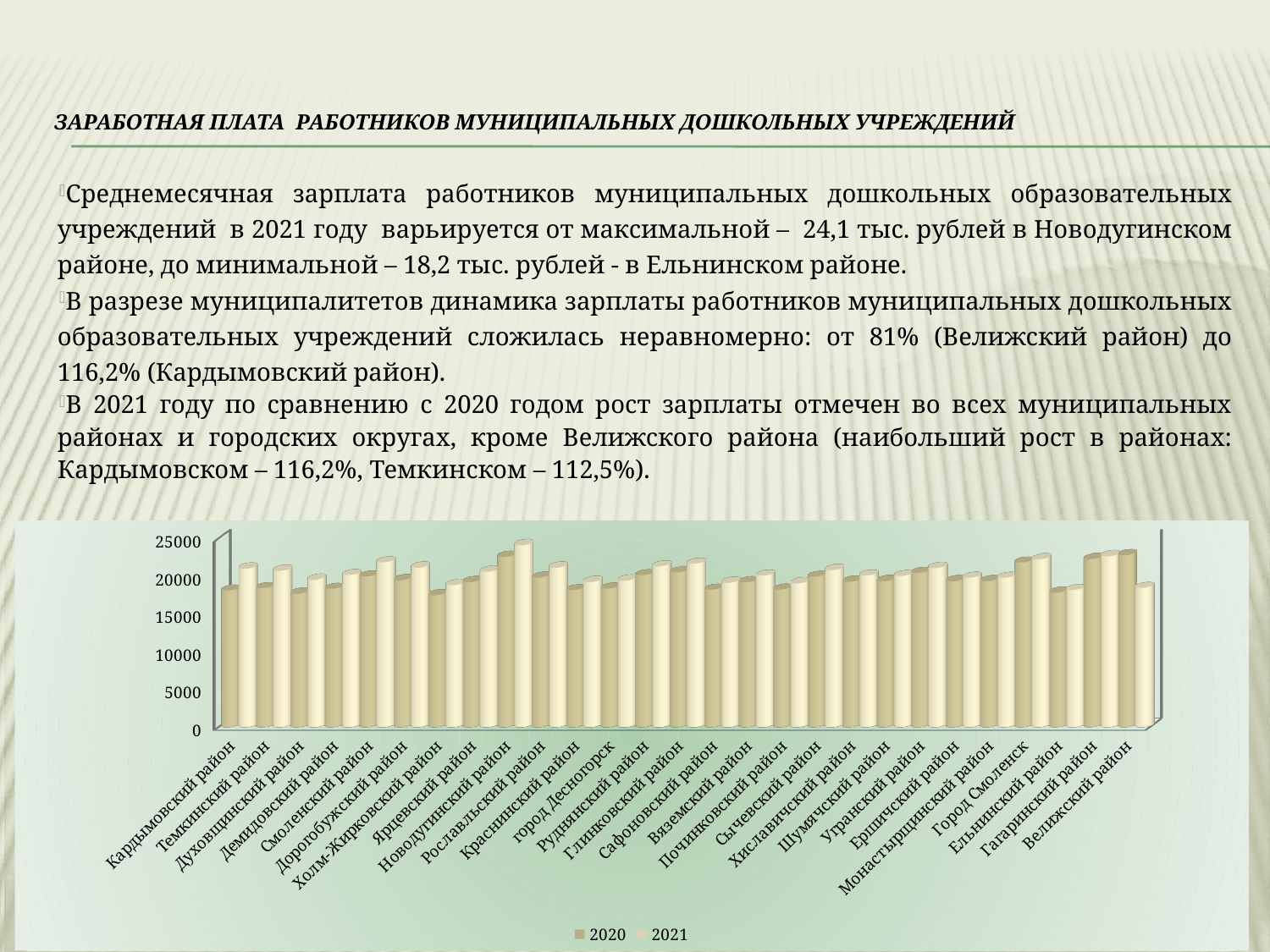
Which is larger: the 2021 value for Новодугинский район or the 2021 value for Кардымовский район? Новодугинский район What kind of chart is shown on the slide? bar chart How many series does the chart legend list? 2 Is the 2021 value for Ельнинский район greater or less than 20000? less Is the 2021 value for Город Смоленск greater or less than 20000? greater Which years are listed in the chart legend? 2020 and 2021 How many municipalities (categories) are shown on the x axis of the chart? 27 Which municipality has the highest 2021 bar in the chart? Новодугинский район Is the 2020 value for Кардымовский район greater or less than 20000? less What is the highest value shown on the vertical axis of the chart? 25000 For Велижский район, which bar is taller: 2020 or 2021? 2020